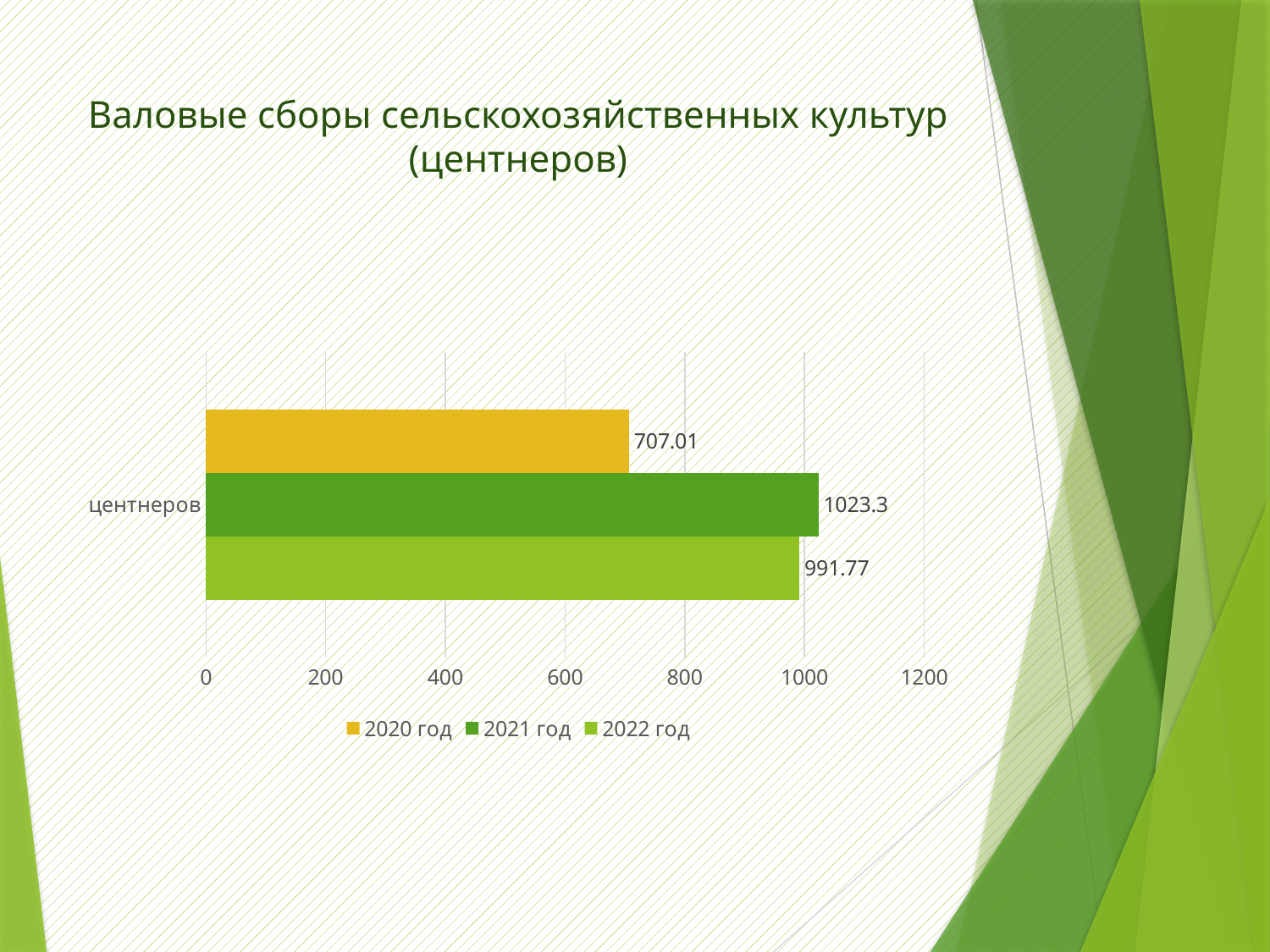
How many series does the legend list? 3 What is the title of the chart? Валовые сборы сельскохозяйственных культур (центнеров) Which year has the lowest value? 2020 год What is the value for 2020 год? 707.01 What is the difference between the values for 2021 год and 2022 год? 31.53 What is the difference between the values for 2021 год and 2020 год? 316.29 What is the value for 2022 год? 991.77 What kind of chart is shown on the slide? bar chart Is the value for 2020 год greater or less than 800? less Which is larger, the value for 2022 год or the value for 2020 год? 2022 год Which year has the highest value? 2021 год What is the value for 2021 год? 1023.3